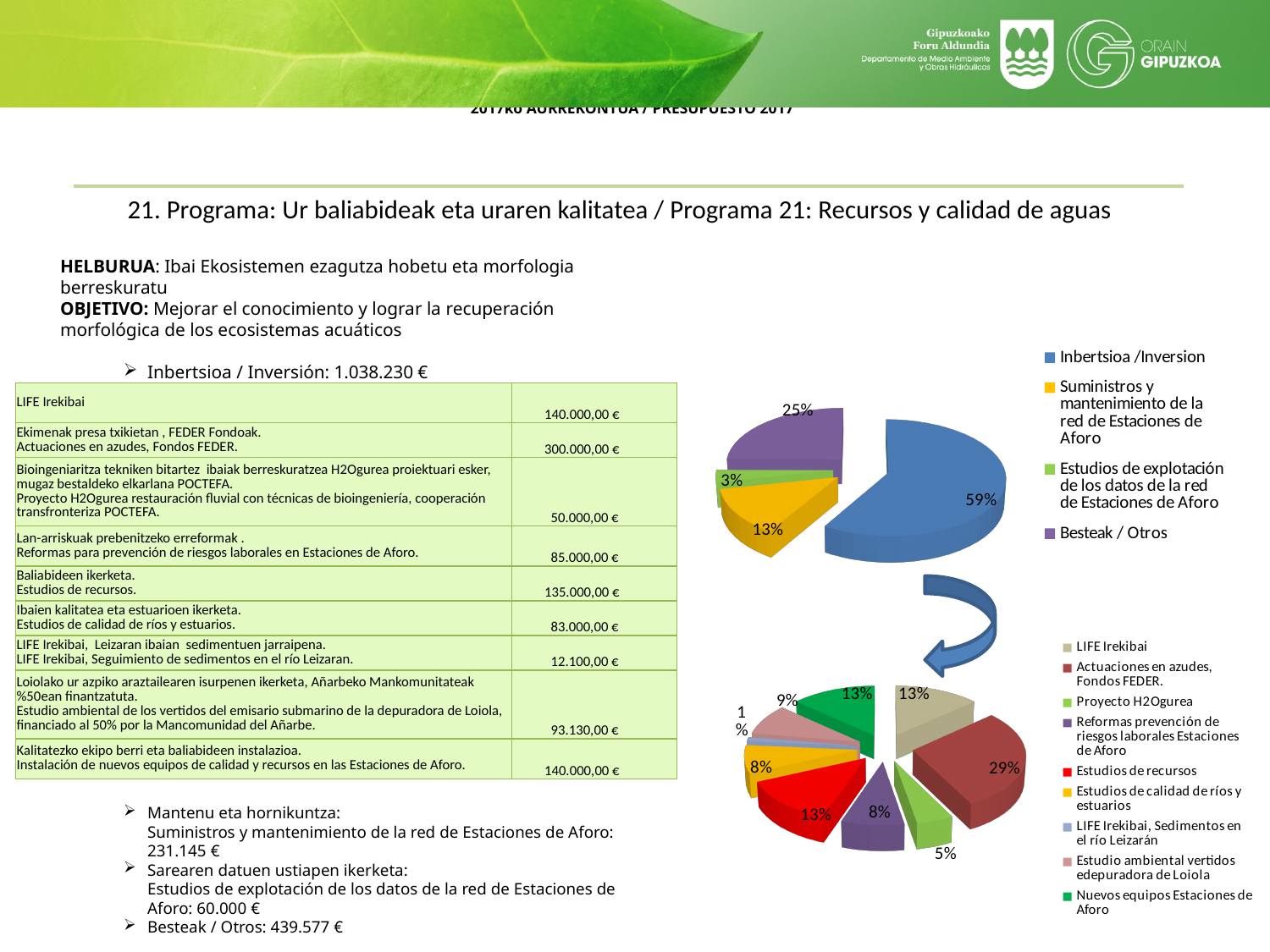
In the top pie chart, what share is shown for Besteak / Otros? 25% How many categories does the legend of the top pie chart list? 4 In the top pie chart, which category has the largest slice? Inbertsioa /Inversion What type of chart is used on this slide? Pie chart In the bottom pie chart, which category has the smallest slice? LIFE Irekibai, Sedimentos en el río Leizarán In the bottom pie chart, which category has the largest slice? Actuaciones en azudes, Fondos FEDER In the top pie chart, what share is shown for Inbertsioa /Inversion? 59% In the top pie chart, which category has the smallest slice? Estudios de explotación de los datos de la red de Estaciones de Aforo In the bottom pie chart, what share is shown for Actuaciones en azudes, Fondos FEDER? 29% How many categories does the legend of the bottom pie chart list? 9